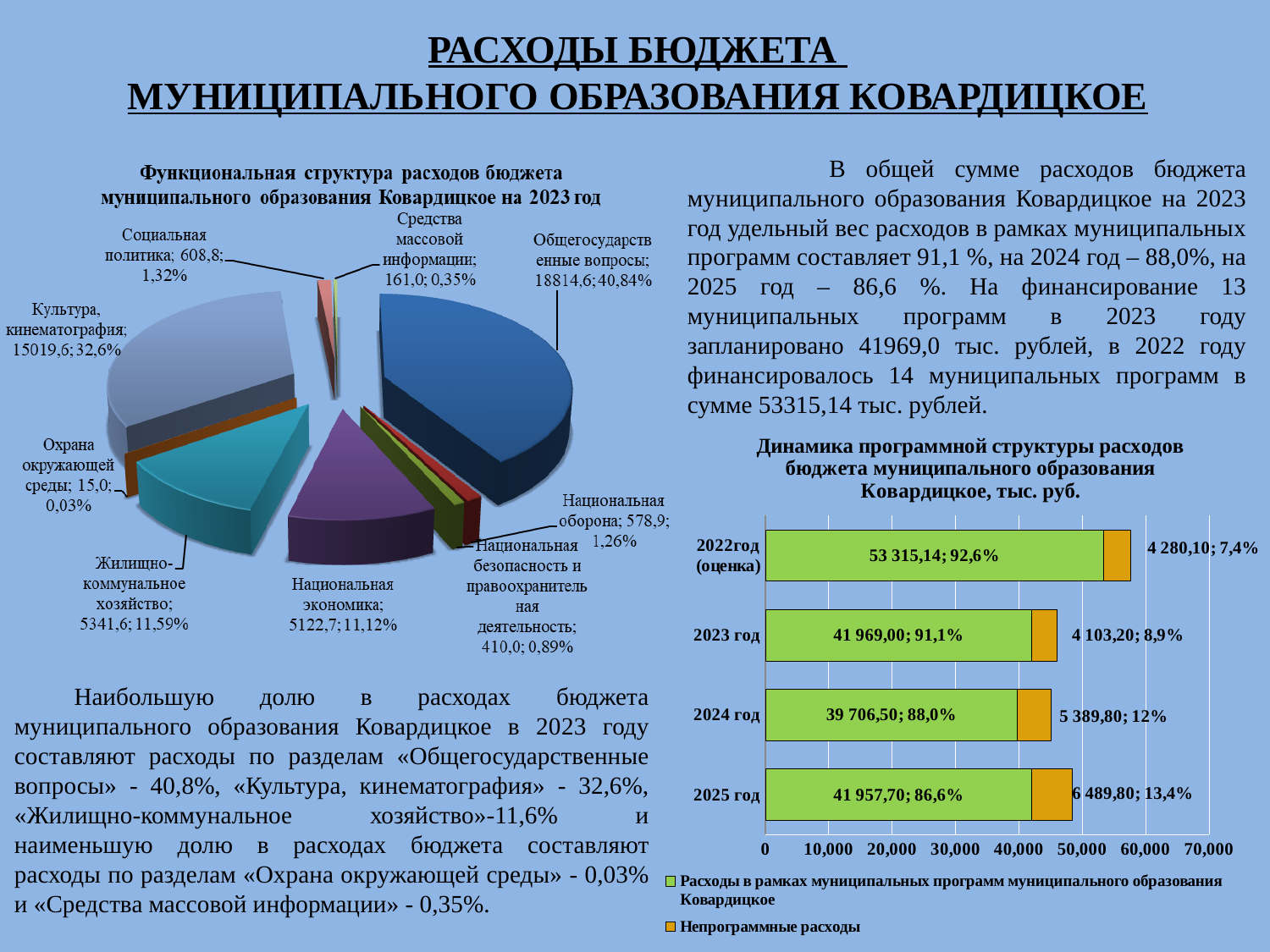
On the bar chart 'Динамика программной структуры расходов', what is the value of 'Расходы в рамках муниципальных программ' for 2024 год? 39 706,50; 88,0% On the pie chart 'Функциональная структура расходов бюджета', how many categories are shown? 9 On the bar chart 'Динамика программной структуры расходов', which year has the highest value of 'Расходы в рамках муниципальных программ'? 2022год (оценка) On the bar chart 'Динамика программной структуры расходов', is 'Непрограммные расходы' for 2025 год larger or smaller than for 2023 год? Larger On the pie chart 'Функциональная структура расходов бюджета', which category has the largest share? Общегосударственные вопросы On the pie chart 'Функциональная структура расходов бюджета', what value is shown for 'Общегосударственные вопросы'? 18814,6; 40,84% What kind of chart is 'Динамика программной структуры расходов бюджета муниципального образования Ковардицкое'? Stacked bar chart On the pie chart 'Функциональная структура расходов бюджета', which category has the smallest share? Охрана окружающей среды On the pie chart 'Функциональная структура расходов бюджета', what is the value for 'Национальная оборона'? 578,9; 1,26% On the pie chart 'Функциональная структура расходов бюджета', what share does 'Культура, кинематография' have? 32,6% On the bar chart 'Динамика программной структуры расходов', what is the value of 'Непрограммные расходы' for 2025 год? 6 489,80; 13,4% On the bar chart 'Динамика программной структуры расходов', how many series does the legend list? 2